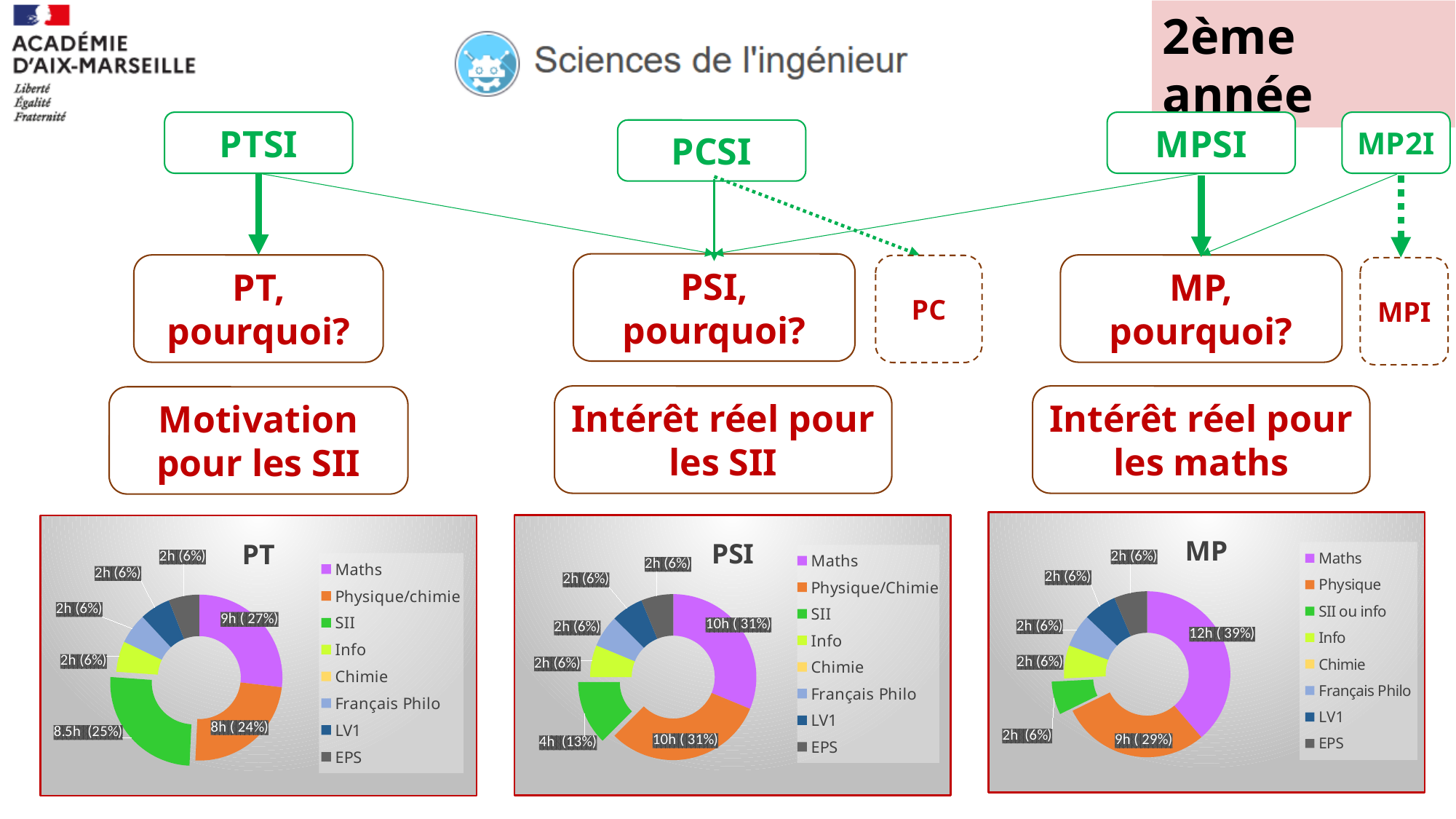
What kind of chart is the PT chart? Doughnut (pie) chart How many entries does the legend of the MP chart list? 8 In the MP chart, what is the value shown for Physique? 9h (29%) In the PSI chart, what is the value shown for Physique/Chimie? 10h (31%) In the PT chart, what is the value shown for Maths? 9h (27%) In the PSI chart, which is larger, Maths or SII? Maths In the PT chart, what is the difference in hours between Maths and Physique/chimie? 1h In the PSI chart, what is the value shown for SII? 4h (13%) In the PT chart, which subject has the largest share? Maths In the PT chart, what is the value shown for SII? 8.5h (25%) In the MP chart, which subject has the largest share? Maths In the MP chart, what is the value shown for Maths? 12h (39%)